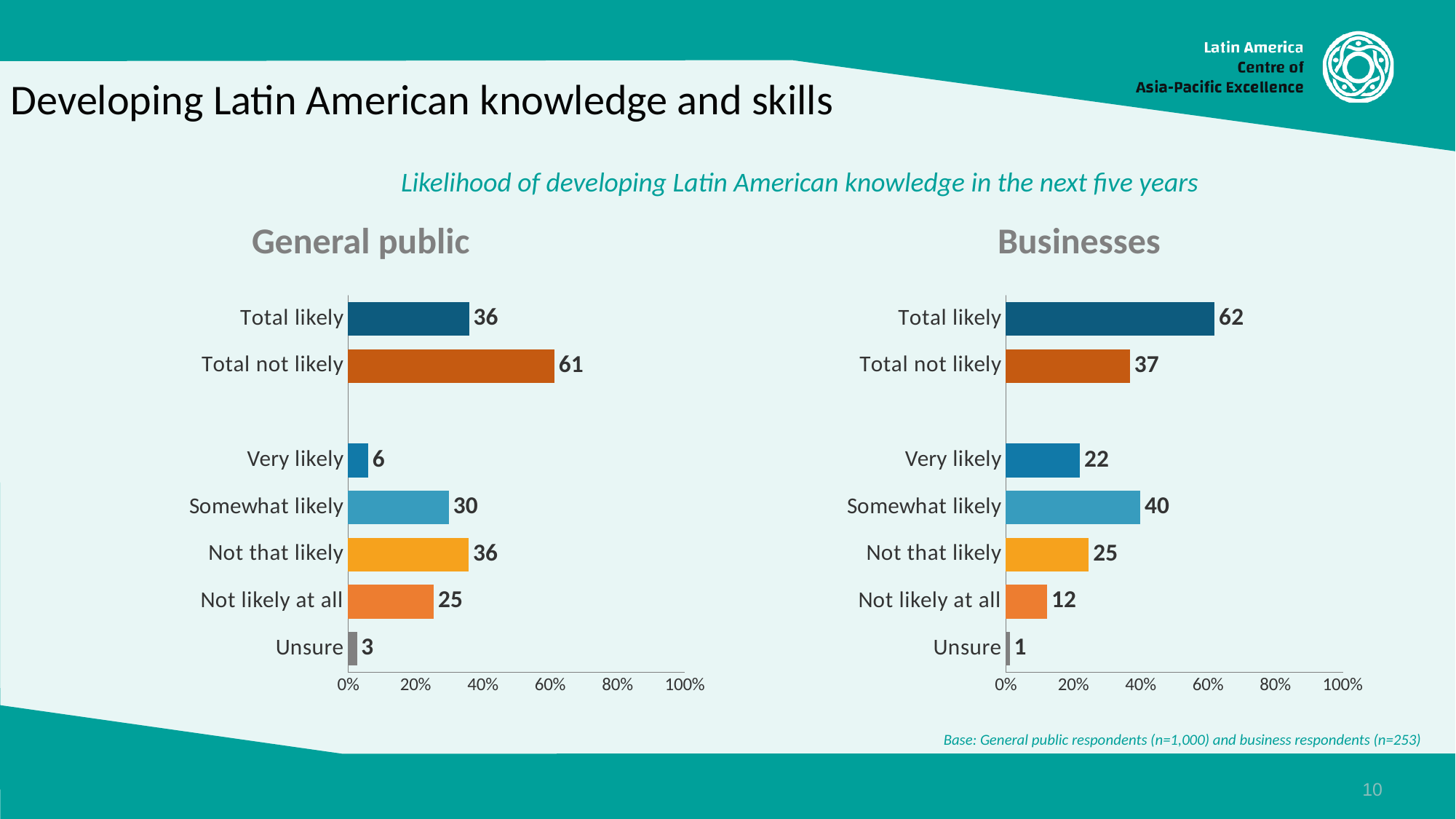
In the Businesses chart, what is the value for Total likely? 62 In the General public chart, what is the value for Very likely? 6 In the General public chart, which is larger, Not that likely or Not likely at all? Not that likely In the Businesses chart, which category has the highest value? Total likely In the Businesses chart, what is the value for Somewhat likely? 40 In the General public chart, which category has the lowest value? Unsure In the Businesses chart, what is the difference between Total likely and Total not likely? 25 What kind of chart is the Businesses chart? Bar chart What is the italic subtitle above the two charts? Likelihood of developing Latin American knowledge in the next five years In the General public chart, what is the value for Total not likely? 61 In the Businesses chart, is the value for Somewhat likely greater or less than 20%? greater How many categories are shown in the General public chart? 7